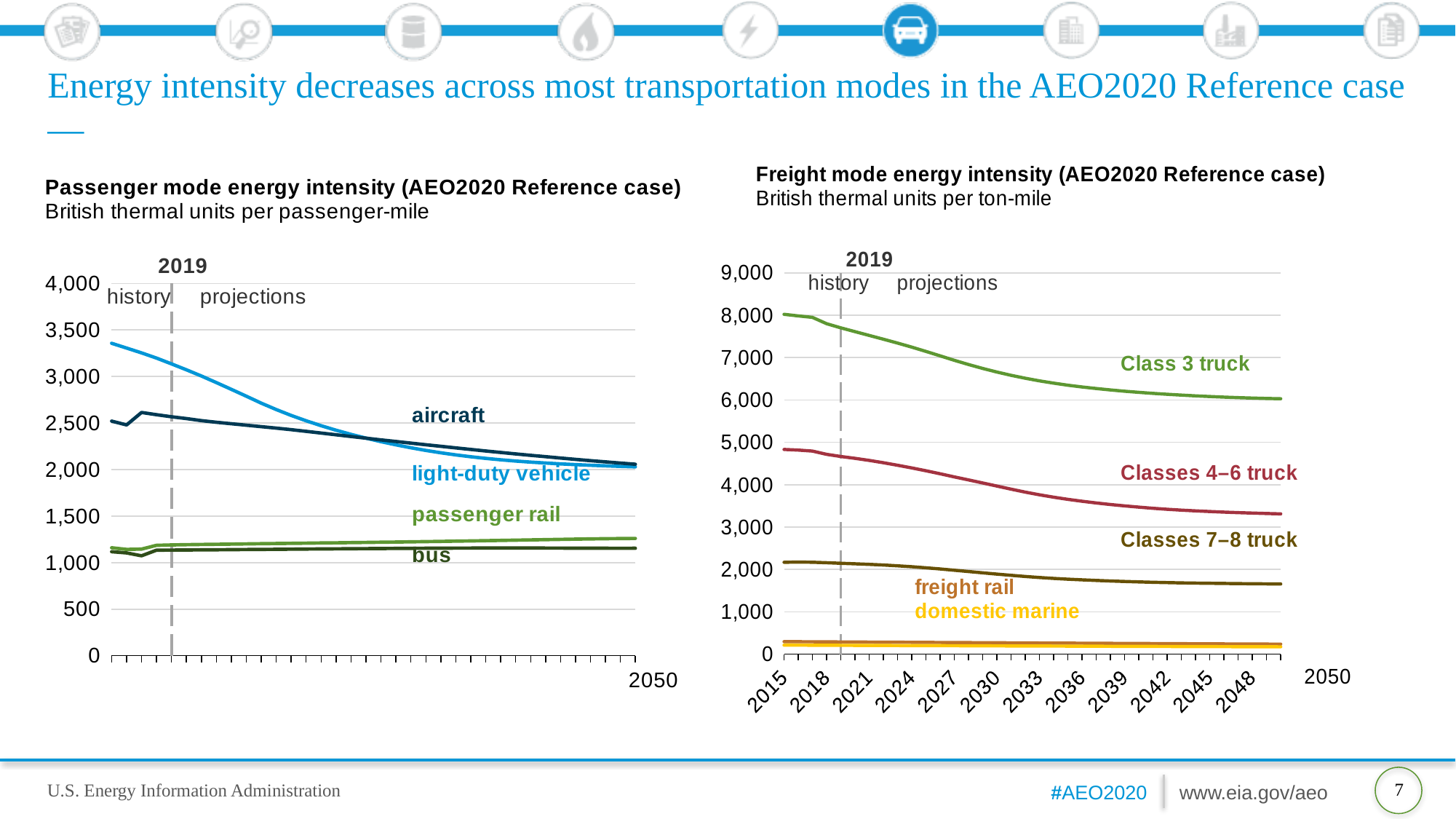
On the Passenger mode energy intensity chart, which series has the lowest value in 2050? bus On the Passenger mode energy intensity chart, is the value for light-duty vehicle in 2019 greater or less than 3,000? greater How many series are plotted on the Freight mode energy intensity chart? 5 On the Freight mode energy intensity chart, is the value for Classes 7–8 truck in 2050 greater or less than 2,000? less On the Freight mode energy intensity chart, does the Class 3 truck series rise or fall over the projection period? fall On the Freight mode energy intensity chart, which series has the highest values throughout the period? Class 3 truck On the Passenger mode energy intensity chart, which series has the higher value at the start of the period (2015): light-duty vehicle or aircraft? light-duty vehicle What unit is used on the Freight mode energy intensity chart? British thermal units per ton-mile What kind of chart is the Passenger mode energy intensity chart? line chart On the Freight mode energy intensity chart, is the value for Classes 4–6 truck in 2050 greater or less than 3,000? greater How many series are plotted on the Passenger mode energy intensity chart? 4 On the Passenger mode energy intensity chart, does the light-duty vehicle series rise or fall from 2019 to 2050? fall